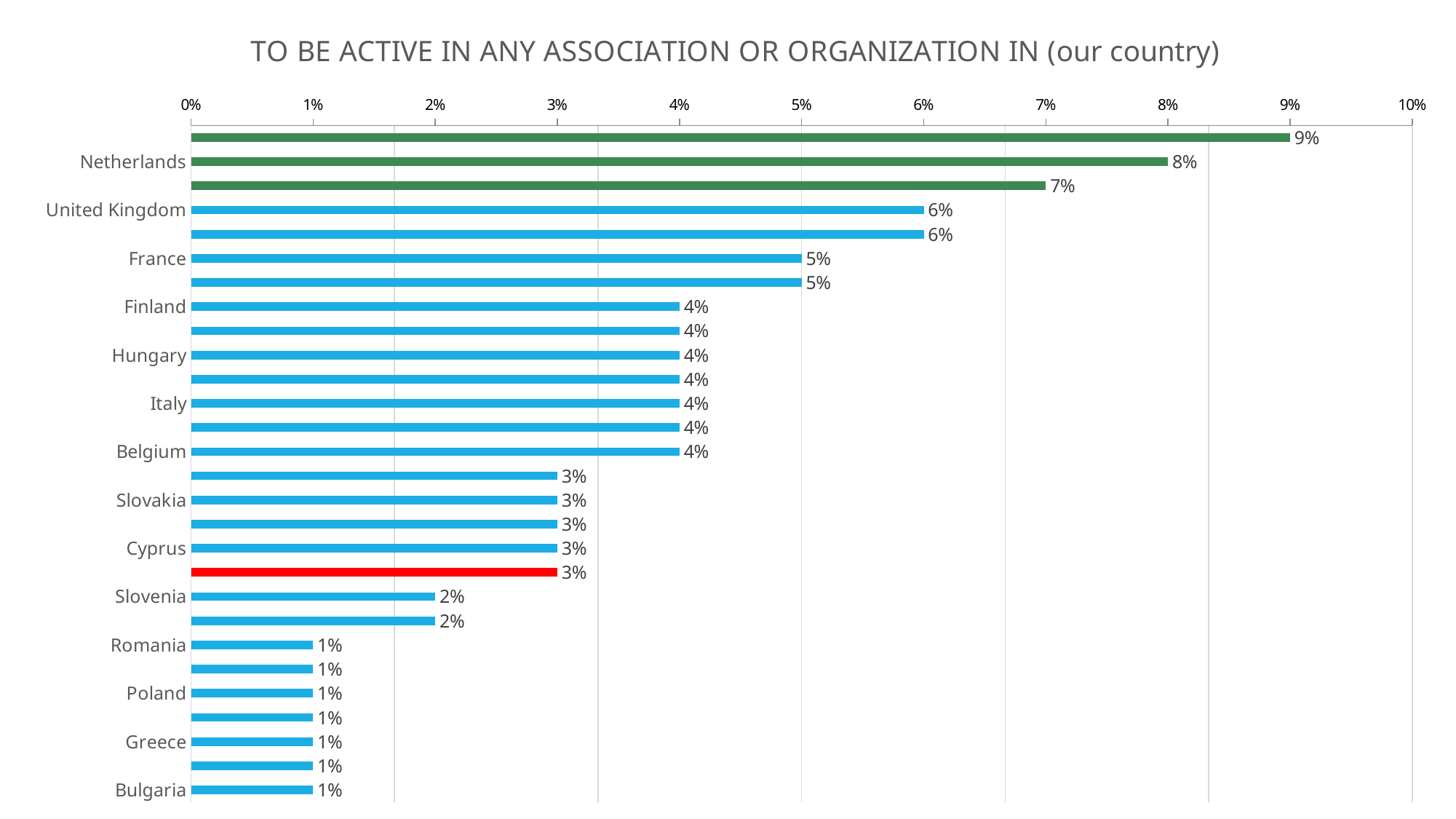
What is the value for Netherlands? 8% What is the value for Bulgaria? 1% What is the difference between the values for Netherlands and United Kingdom? 2% How many bars are plotted on the chart? 28 What is the highest value shown on the chart? 9% What is the value for Slovenia? 2% Which has a larger value, Netherlands or France? Netherlands What is the lowest value shown on the chart? 1% What kind of chart is shown on the slide? Bar chart What is the value of the red bar? 3% What is the value for United Kingdom? 6% Is the value for Netherlands greater or less than 5%? greater